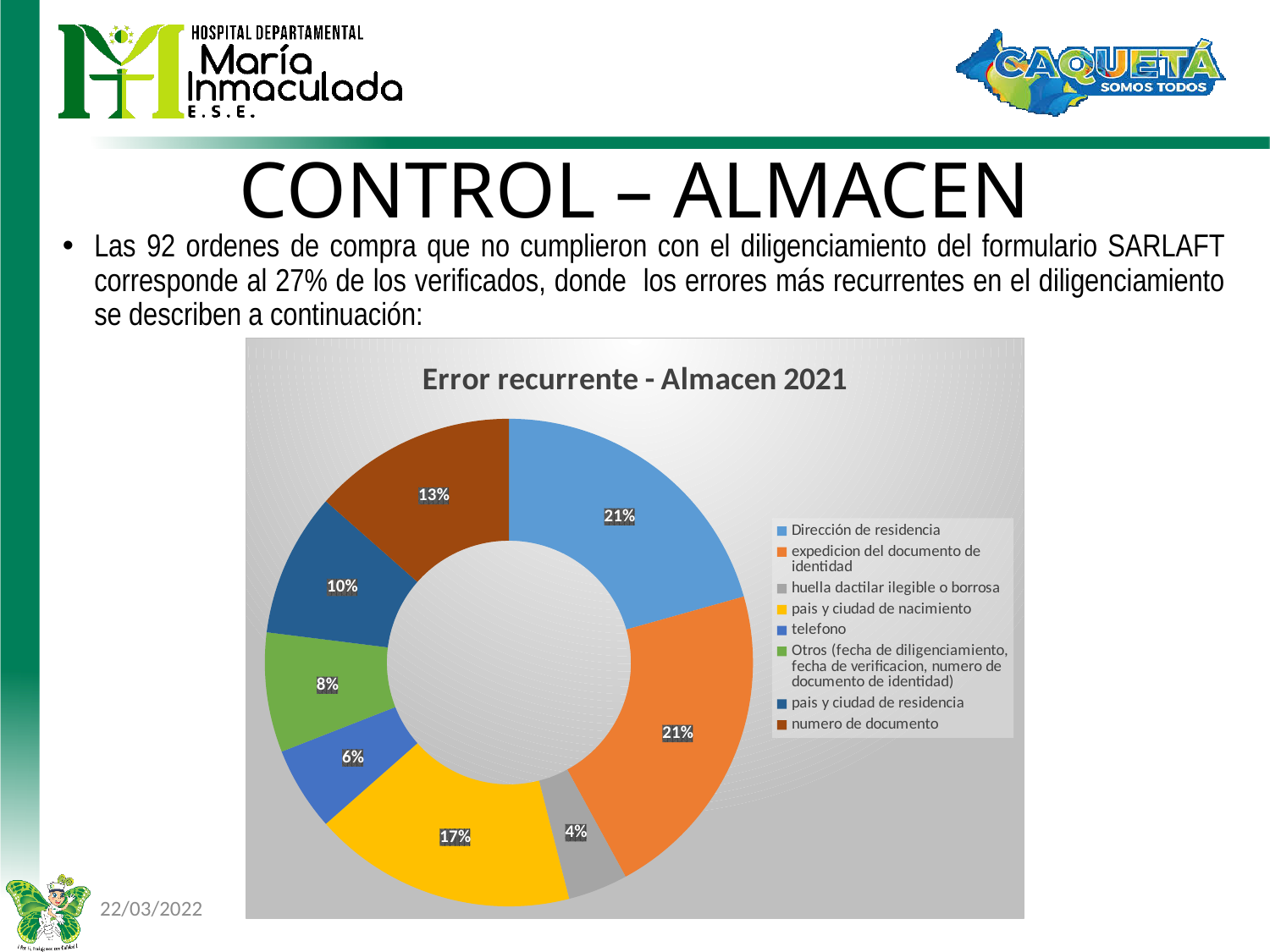
What is the difference in percentage points between 'Dirección de residencia' and 'telefono'? 15 What percentage does the chart show for 'telefono'? 6% What percentage does the chart show for 'pais y ciudad de residencia'? 10% What percentage does the chart show for 'numero de documento'? 13% Which category has the smallest share in the chart? huella dactilar ilegible o borrosa What kind of chart is shown on the slide? Doughnut chart What percentage does the chart show for 'pais y ciudad de nacimiento'? 17% What is the combined share of 'pais y ciudad de residencia' and 'numero de documento'? 23% What is the title of the chart? Error recurrente - Almacen 2021 How many categories does the legend list? 8 What percentage does the chart show for 'huella dactilar ilegible o borrosa'? 4% Which is larger: the share for 'pais y ciudad de nacimiento' or the share for 'numero de documento'? pais y ciudad de nacimiento